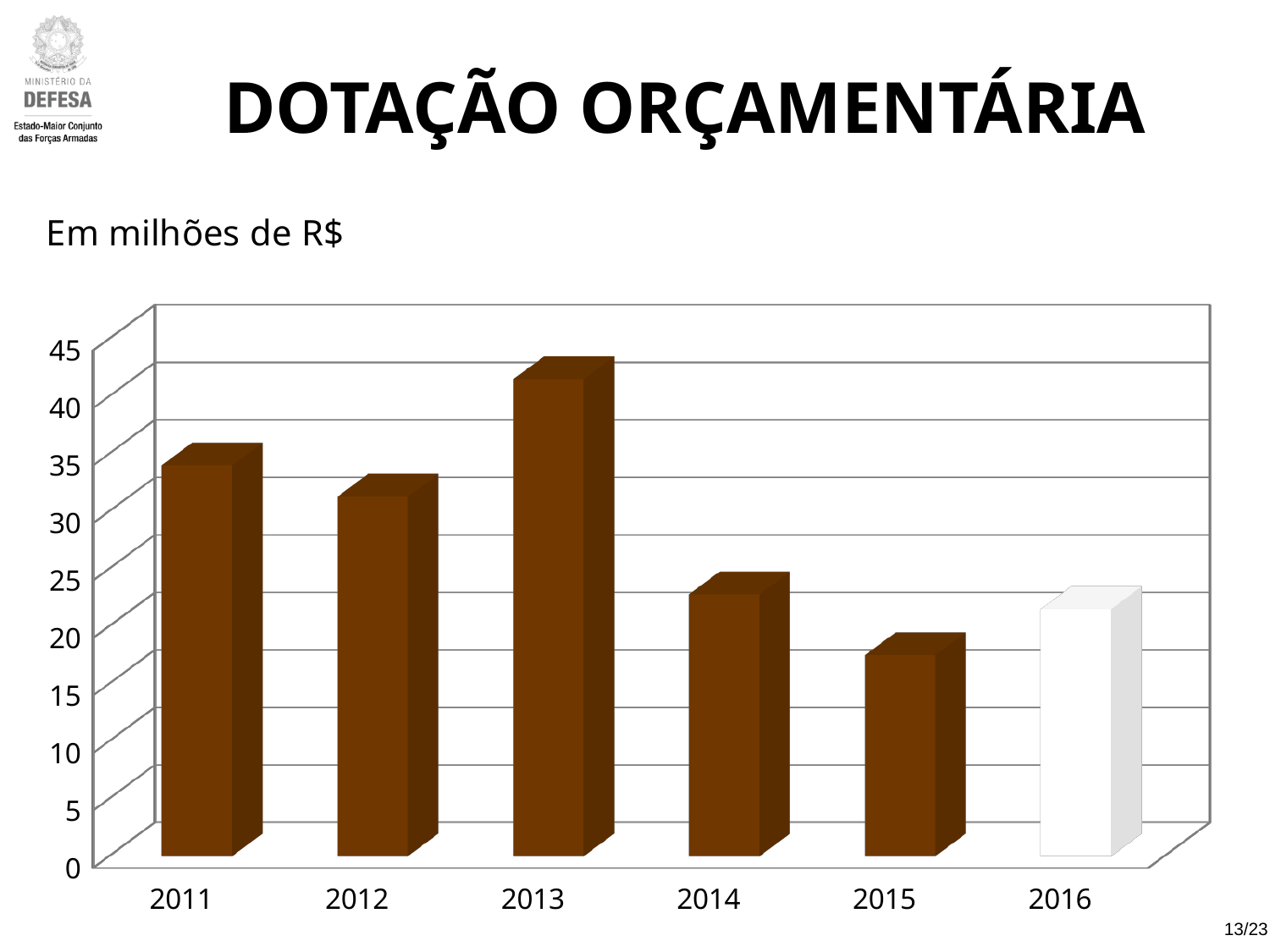
Is the value for 2014 greater or less than 25? less Is the value for 2013 greater or less than 35? greater Do the values rise or fall from 2013 to 2015? fall What kind of chart is shown on the slide? Bar chart Is the value for 2015 greater or less than 20? less How many years are shown on the x axis of the chart? 6 In what unit are the values of the chart expressed, according to the slide? Em milhões de R$ Which year has the lowest budget allocation in the chart? 2015 Which year has a larger value, 2011 or 2012? 2011 Which year has the highest budget allocation in the chart? 2013